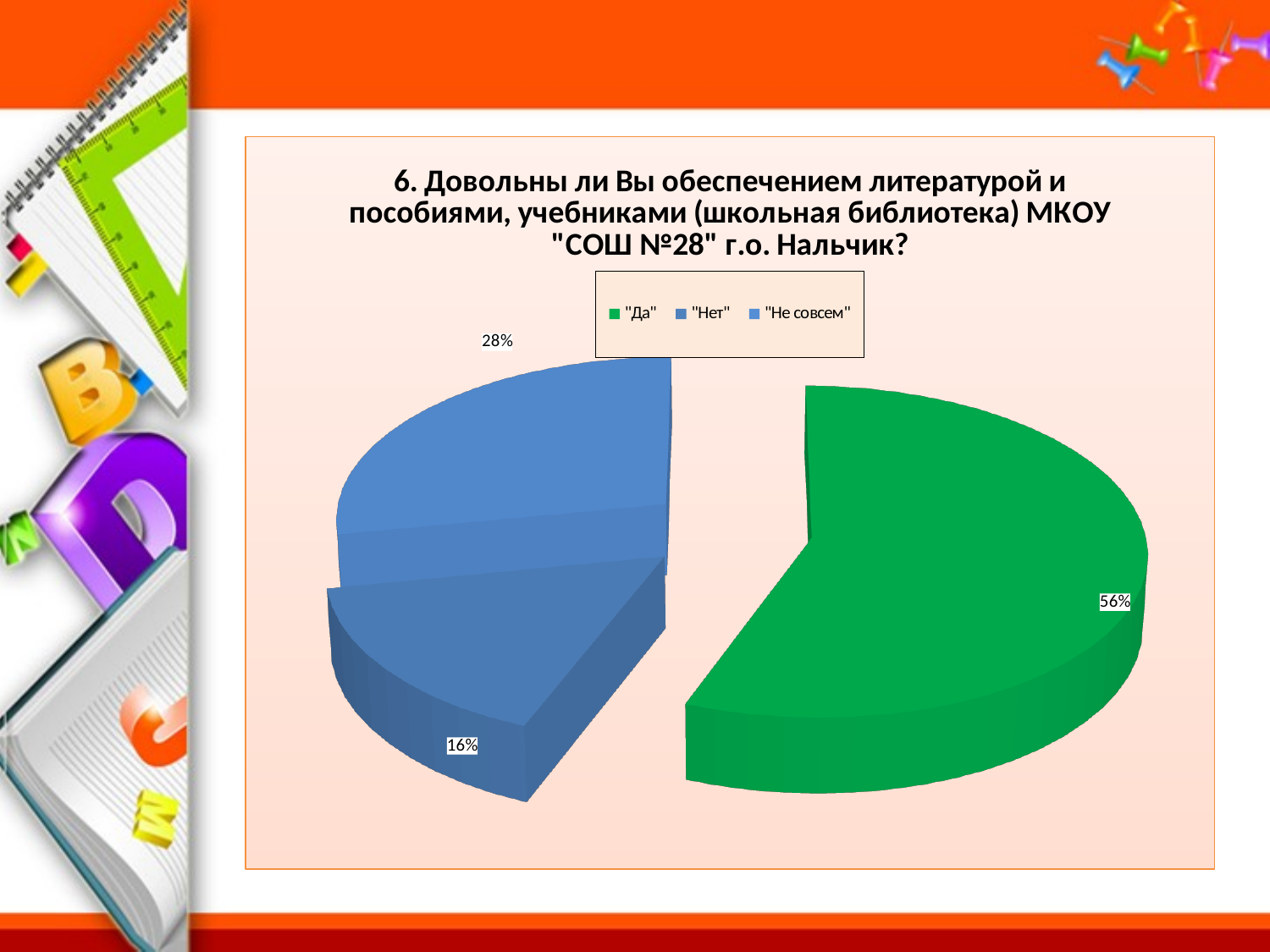
What kind of chart is shown on the slide? pie chart What is the difference in percentage points between the "Да" and "Нет" slices? 40 What percentage of respondents answered "Да"? 56% Which is larger: the share for "Не совсем" or the share for "Нет"? "Не совсем" What percentage of respondents answered "Не совсем"? 28% How many slices does the pie chart have? 3 Which answer has the largest share of the pie? "Да" What percentage of respondents answered "Нет"? 16% What colour is the slice representing "Да"? green Which answer has the smallest share of the pie? "Нет" How many entries does the legend list? 3 What number does the question in the chart title begin with? 6